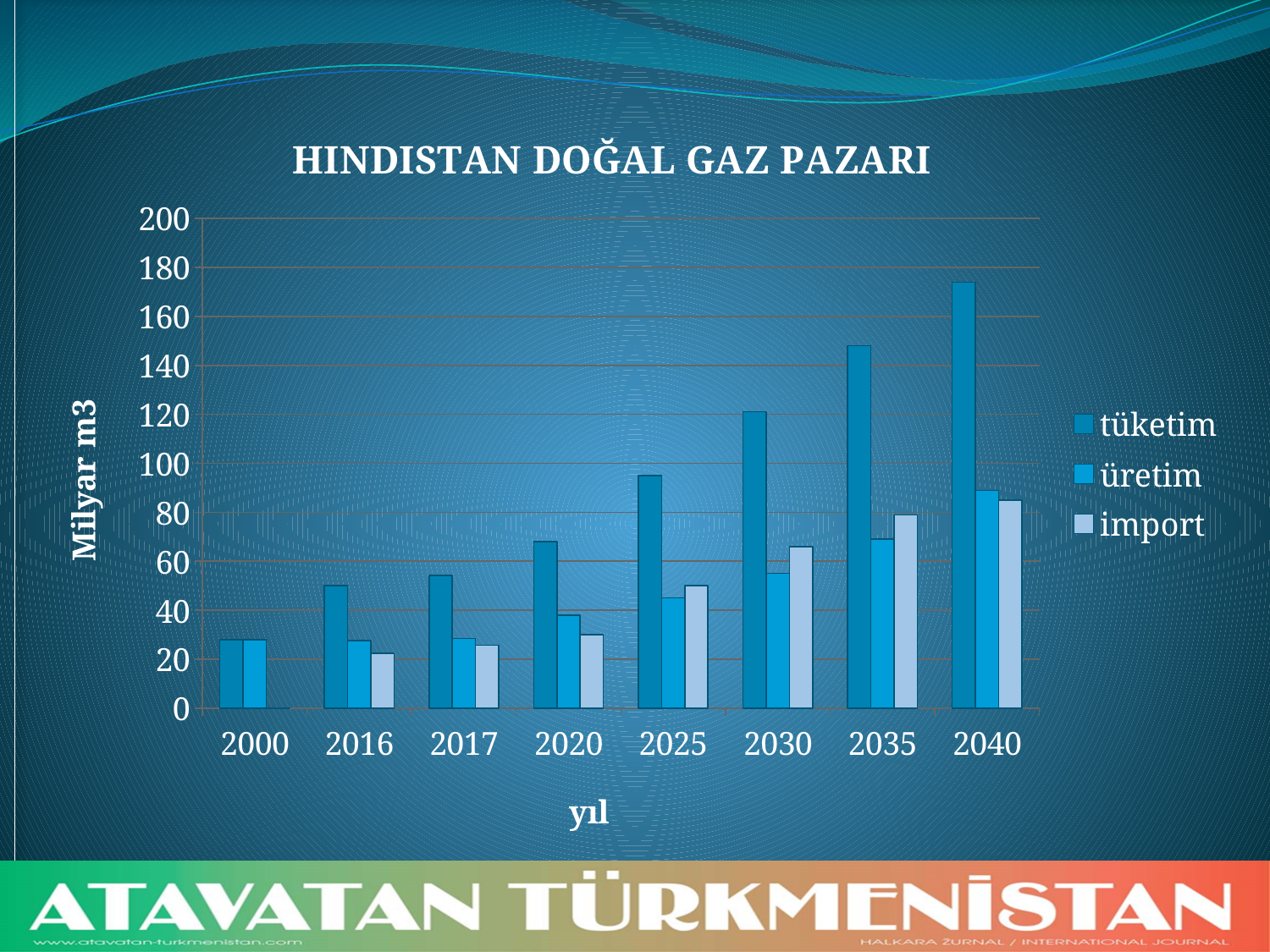
In 2030, which is larger: tüketim or import? tüketim Is the value for üretim in 2030 greater or less than 60? less How many years are shown on the x axis? 8 What kind of chart is shown on the slide? bar chart How many series does the legend list? 3 Is the value for tüketim in 2040 greater or less than 160? greater In which year is import lowest? 2000 What is the title of the chart? HINDISTAN DOĞAL GAZ PAZARI What is the label of the y axis? Milyar m3 Does tüketim rise or fall from 2000 to 2040? rise Is the value for import in 2035 greater or less than 60? greater In which year is tüketim highest? 2040